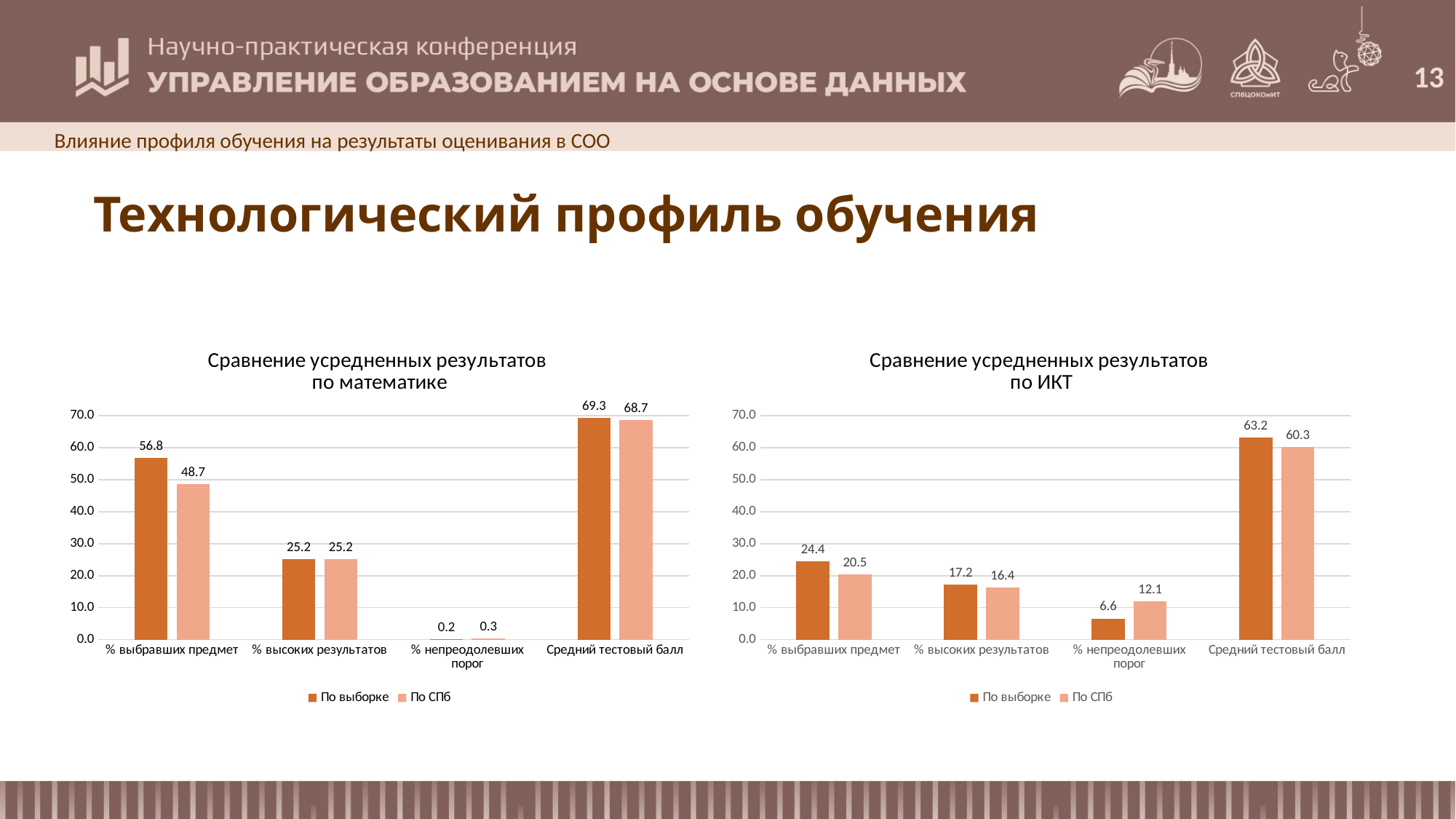
What kind of chart is 'Сравнение усредненных результатов по математике'? Bar chart In the chart 'Сравнение усредненных результатов по математике', what is the difference between 'По выборке' and 'По СПб' for '% выбравших предмет'? 8.1 In the chart 'Сравнение усредненных результатов по ИКТ', what is the difference between 'По выборке' and 'По СПб' for '% выбравших предмет'? 3.9 In the chart 'Сравнение усредненных результатов по математике', how many series does the legend list? 2 In the chart 'Сравнение усредненных результатов по ИКТ', what is the value of 'По СПб' for '% непреодолевших порог'? 12.1 How many categories are shown on the x axis of the chart 'Сравнение усредненных результатов по ИКТ'? 4 In the chart 'Сравнение усредненных результатов по ИКТ', what is the value of 'По выборке' for 'Средний тестовый балл'? 63.2 In the chart 'Сравнение усредненных результатов по ИКТ', which category has the highest 'По СПб' value? Средний тестовый балл In the chart 'Сравнение усредненных результатов по математике', what is the value of 'По выборке' for '% выбравших предмет'? 56.8 In the chart 'Сравнение усредненных результатов по математике', what is the value of 'По СПб' for 'Средний тестовый балл'? 68.7 In the chart 'Сравнение усредненных результатов по ИКТ', which is larger for '% непреодолевших порог': 'По выборке' or 'По СПб'? По СПб In the chart 'Сравнение усредненных результатов по математике', which category has the lowest 'По выборке' value? % непреодолевших порог